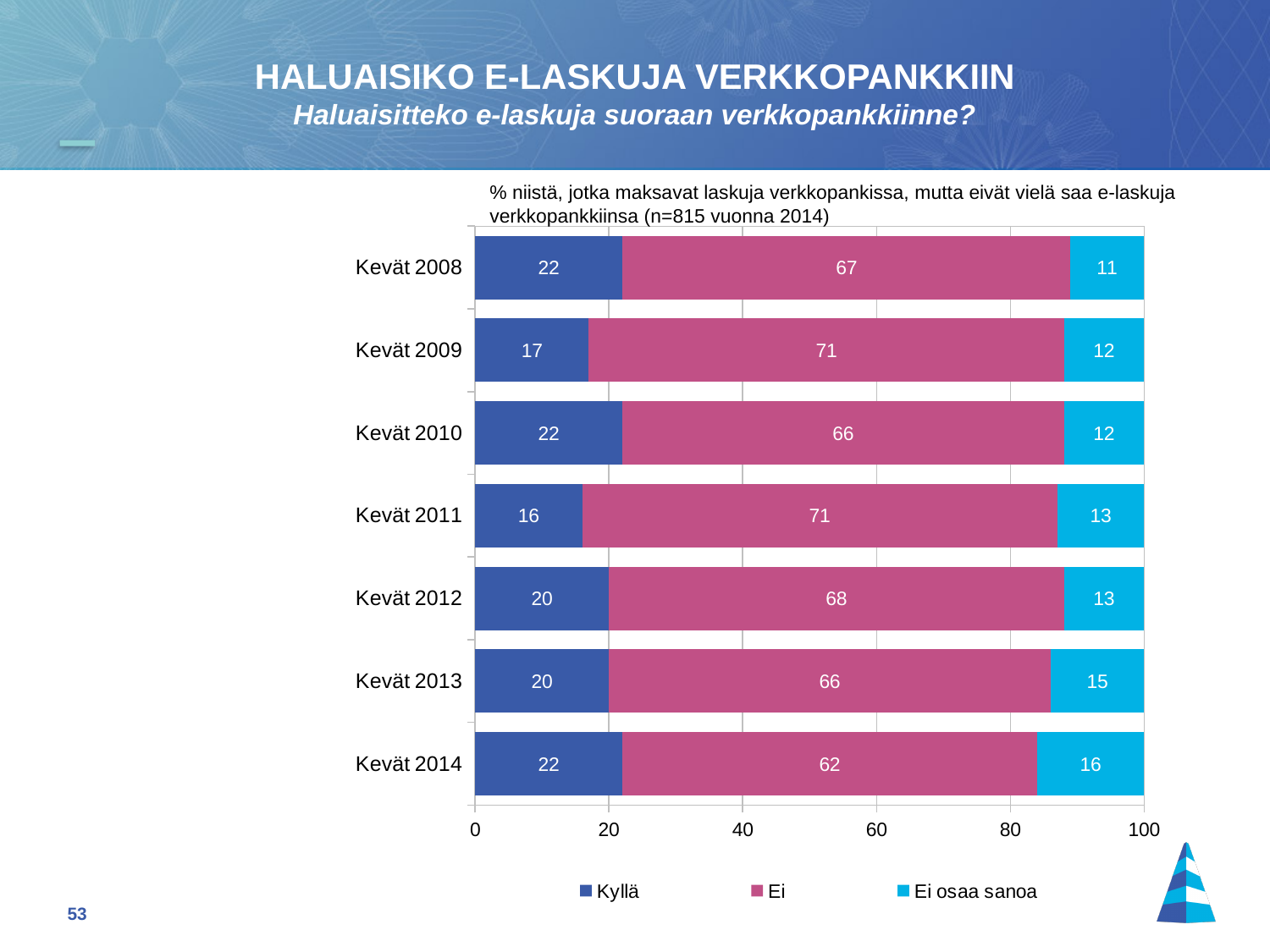
Which year has the highest value for Ei osaa sanoa? Kevät 2014 How many years (categories) are shown on the chart? 7 Which series is shown in pink? Ei What is the value for Ei in Kevät 2009? 71 What is the difference between the Ei values for Kevät 2008 and Kevät 2014? 5 What is the total of the stacked bar for Kevät 2012? 101 What kind of chart is shown on the slide? Stacked bar chart Is the Kyllä value larger in Kevät 2010 or Kevät 2012? Kevät 2010 Which year has the lowest value for Kyllä? Kevät 2011 How many series does the legend list? 3 What is the value for Ei osaa sanoa in Kevät 2013? 15 What is the value for Kyllä in Kevät 2014? 22